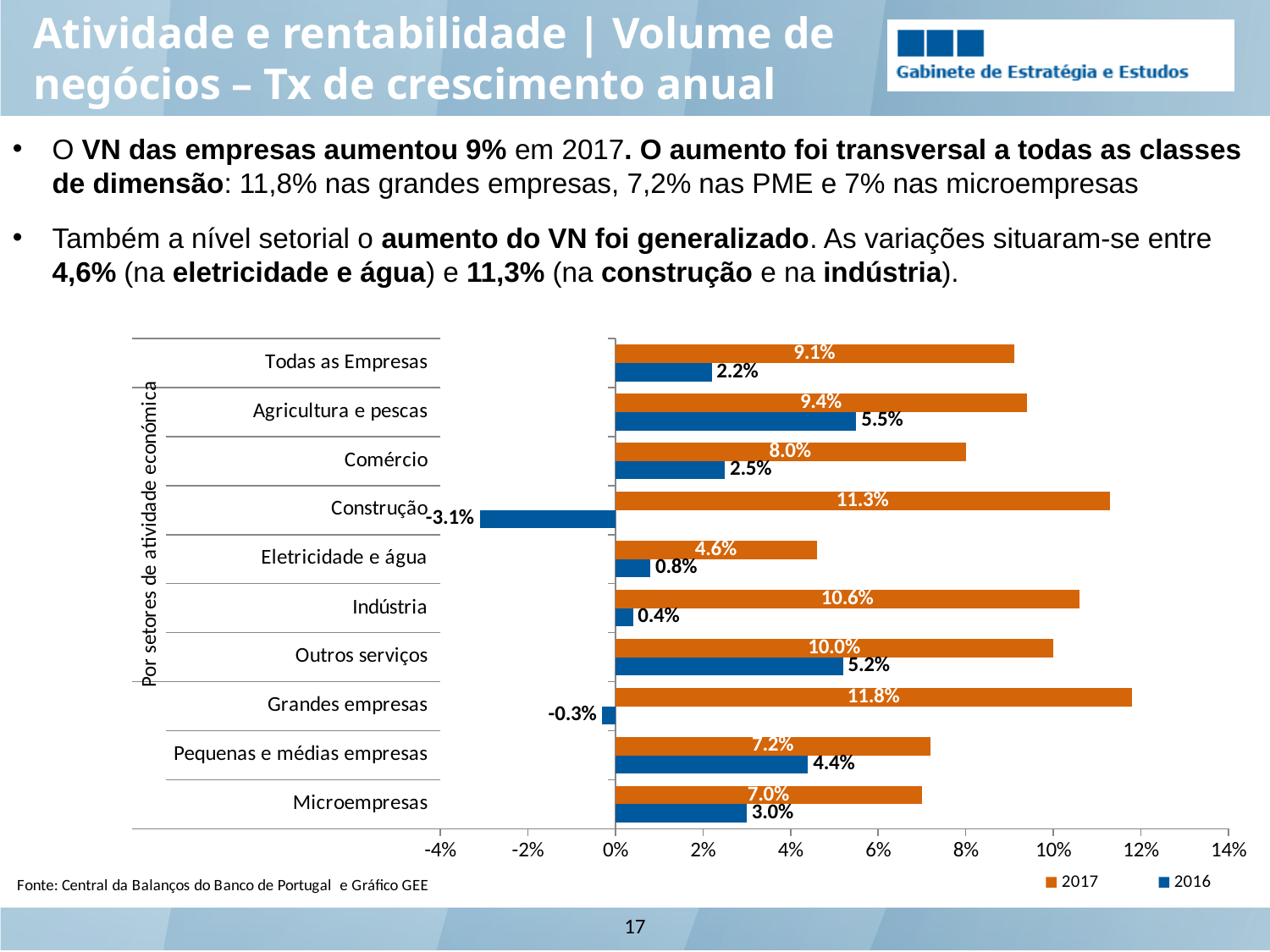
What is the 2016 value for Grandes empresas? -0.3% What is the 2016 value for Agricultura e pescas? 5.5% Which category has the lowest 2017 value? Eletricidade e água Which is larger: the 2016 value for Outros serviços or the 2016 value for Pequenas e médias empresas? Outros serviços What is the difference between the 2017 and 2016 values for Todas as Empresas? 6.9 percentage points What is the 2017 value for Microempresas? 7.0% What is the 2017 value for Construção? 11.3% Which category has the highest 2017 value? Grandes empresas How many series does the legend list? 2 Which category has the lowest 2016 value? Construção What kind of chart is shown on the slide? Bar chart How many categories are shown on the chart? 10